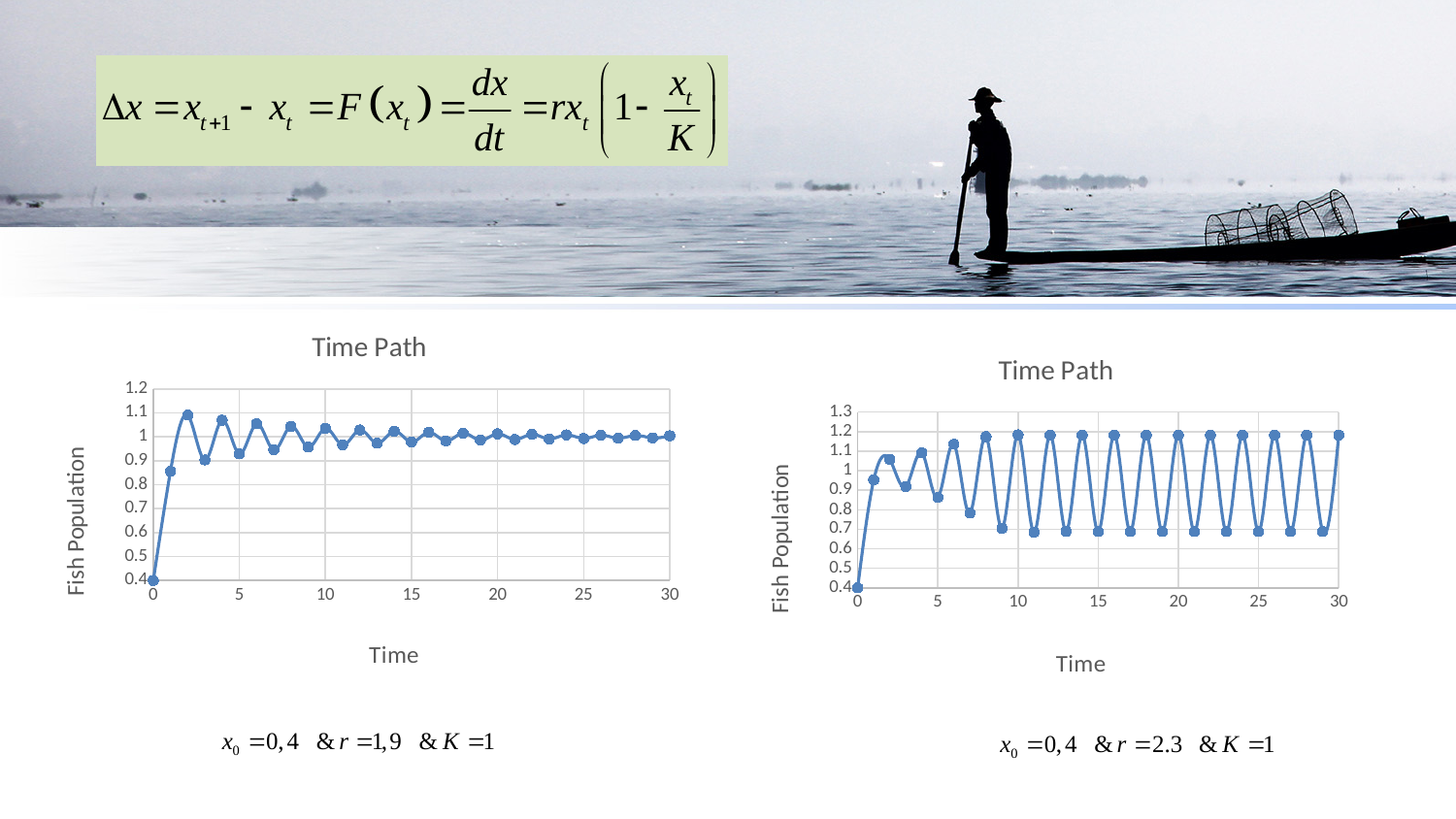
In the left 'Time Path' chart, is the value at time 3 greater or less than 1? less In the left 'Time Path' chart, do the oscillations grow or shrink as time increases? shrink In the right 'Time Path' chart, is the value at time 11 greater or less than 0.8? less In the right 'Time Path' chart, at which time is the fish population lowest? 0 In the left 'Time Path' chart, at which time is the fish population lowest? 0 In the left 'Time Path' chart, at which time is the fish population highest? 2 In the right 'Time Path' chart, what is the fish population value at time 0? 0.4 In the right 'Time Path' chart, is the value at time 10 greater or less than 1.1? greater In the left 'Time Path' chart, what is the fish population value at time 0? 0.4 What kind of chart is the left 'Time Path' chart? line chart What is the y-axis title of the right 'Time Path' chart? Fish Population